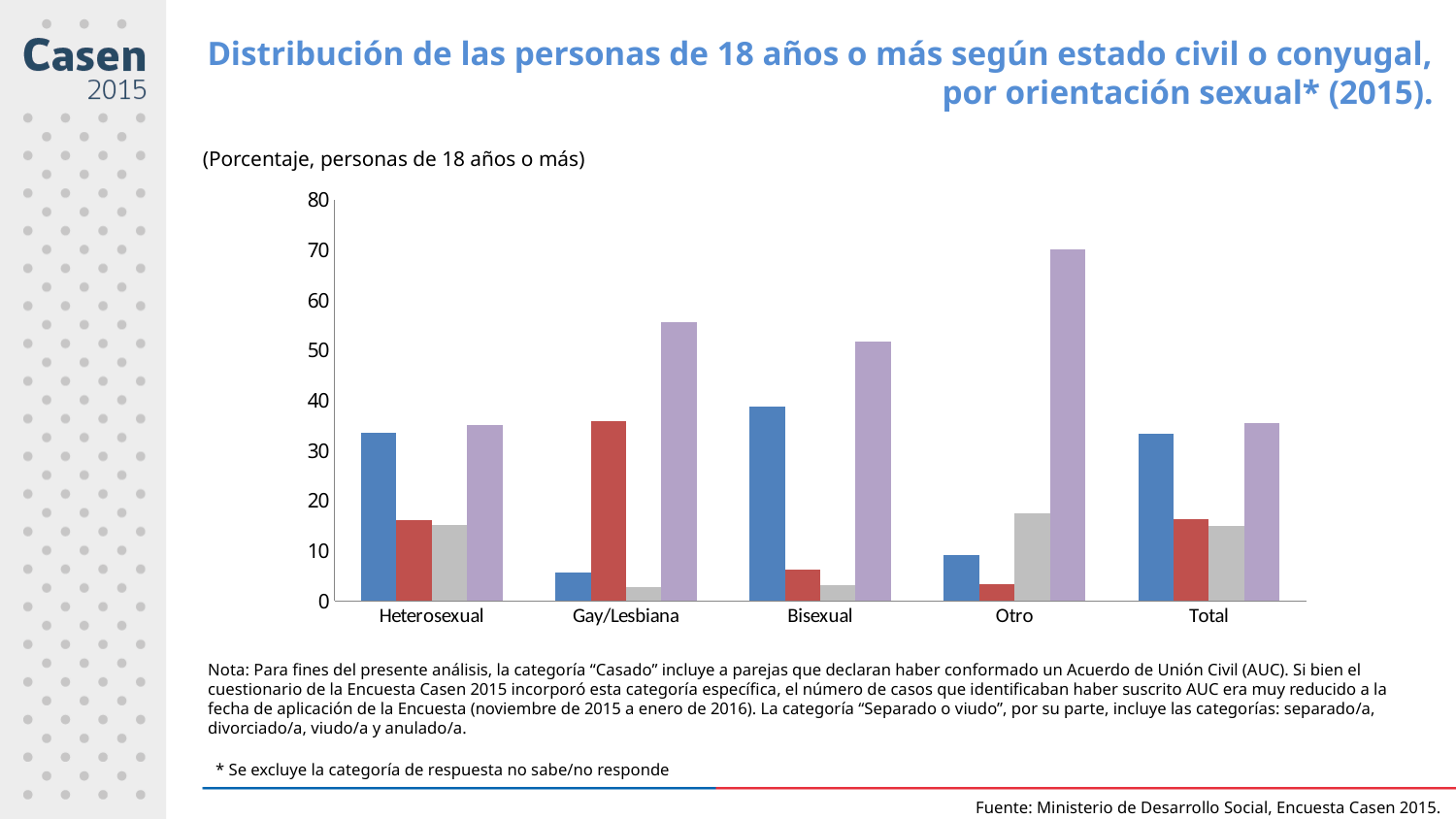
Is the value of the gray bar for Bisexual greater or less than 10? less Which category has the tallest red bar? Gay/Lesbiana What kind of chart is shown on the slide? bar chart Which is larger, the blue bar for Bisexual or the blue bar for Heterosexual? Bisexual How many bars are plotted for each category on the x axis? 4 How many categories are shown on the x axis of the chart? 5 Is the value of the purple bar for Otro greater or less than 60? greater Is the value of the purple bar for Gay/Lesbiana greater or less than 50? greater Which category has the shortest blue bar? Gay/Lesbiana Which category has the tallest purple bar? Otro